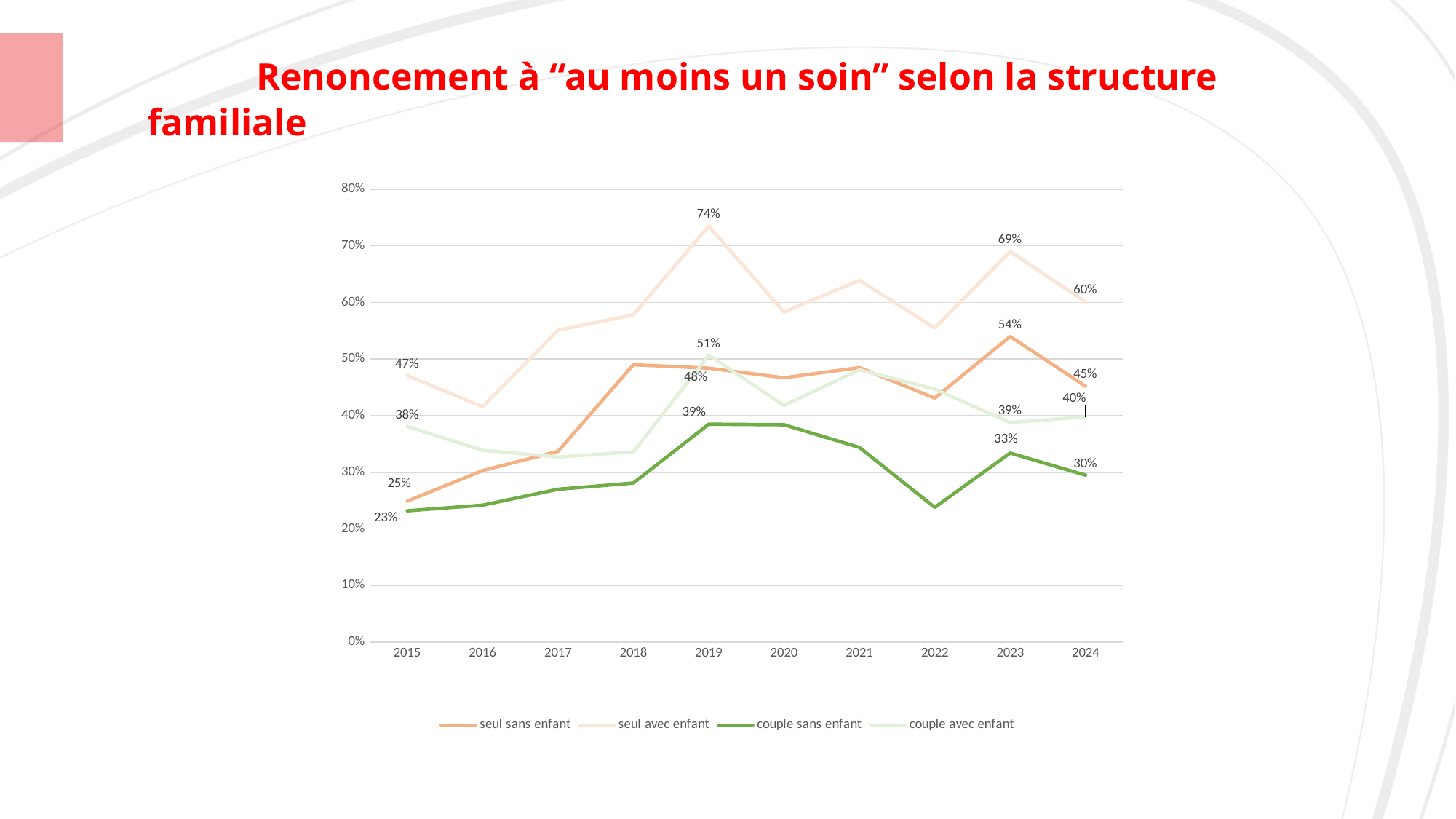
What is the value for "couple avec enfant" in 2015? 38% What is the value for "seul sans enfant" in 2023? 54% What is the value for "couple sans enfant" in 2024? 30% In 2023, which is larger: "seul sans enfant" or "couple avec enfant"? seul sans enfant Which series has the highest value in 2019? seul avec enfant How many series does the legend list? 4 What is the difference between the "seul avec enfant" values in 2019 and 2024? 14 percentage points Which series has the lowest value in 2024? couple sans enfant How many years are shown on the x axis? 10 What kind of chart is shown on the slide? line chart What is the value for "seul avec enfant" in 2019? 74% Is the value for "seul avec enfant" in 2022 greater or less than 50%? greater